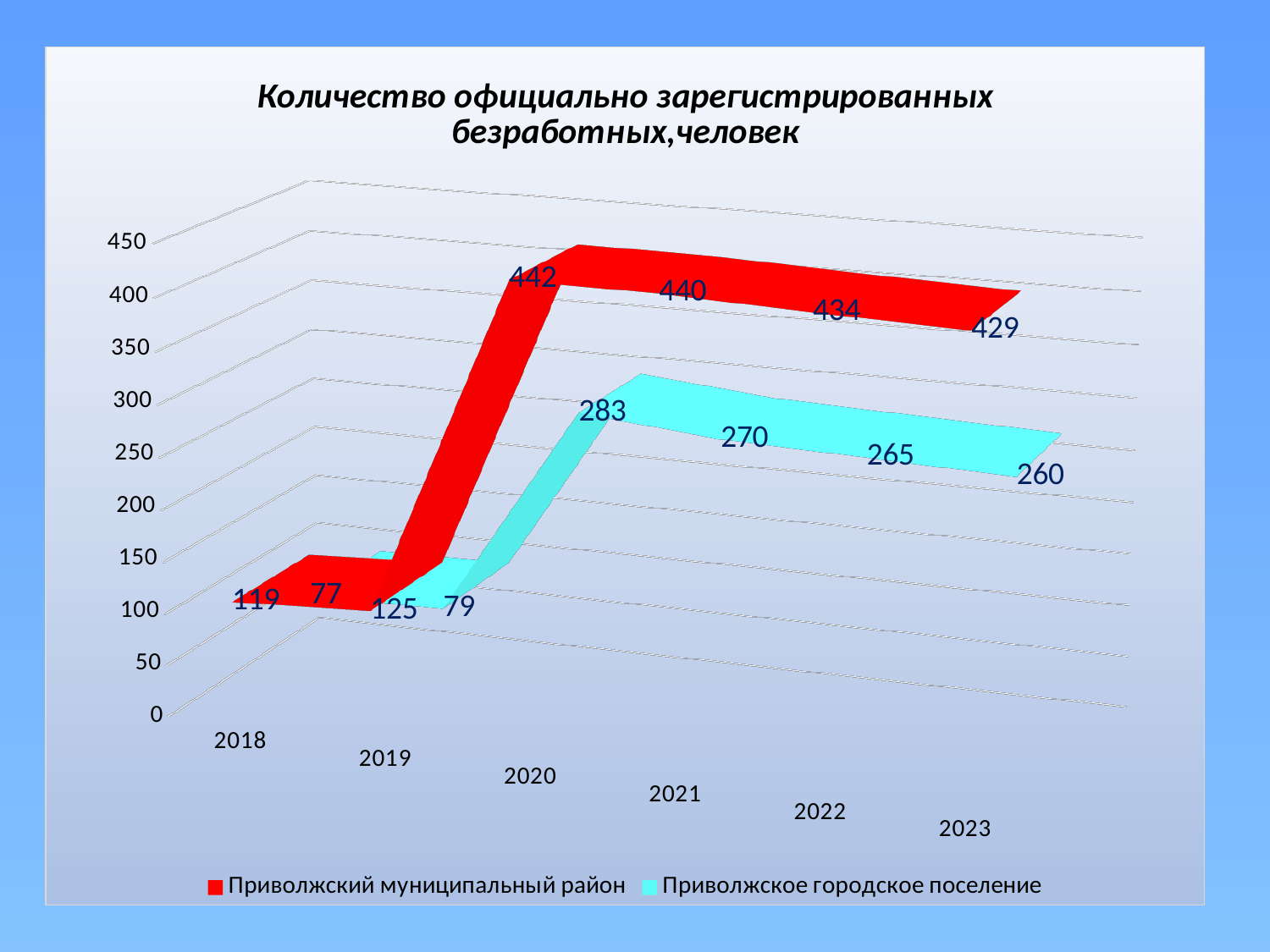
Which series has the larger value in 2022: Приволжский муниципальный район or Приволжское городское поселение? Приволжский муниципальный район How many series does the legend list? 2 What type of chart is shown on the slide? line chart Does the value for Приволжский муниципальный район rise or fall from 2020 to 2023? fall What is the difference between the 2020 values of Приволжский муниципальный район and Приволжское городское поселение? 159 What is the title of the chart? Количество официально зарегистрированных безработных,человек In which year is the value for Приволжское городское поселение lowest? 2018 What is the value for Приволжский муниципальный район in 2020? 442 What is the value for Приволжское городское поселение in 2018? 77 What is the value for Приволжское городское поселение in 2023? 260 In which year is the value for Приволжский муниципальный район highest? 2020 How many years are shown on the x axis? 6